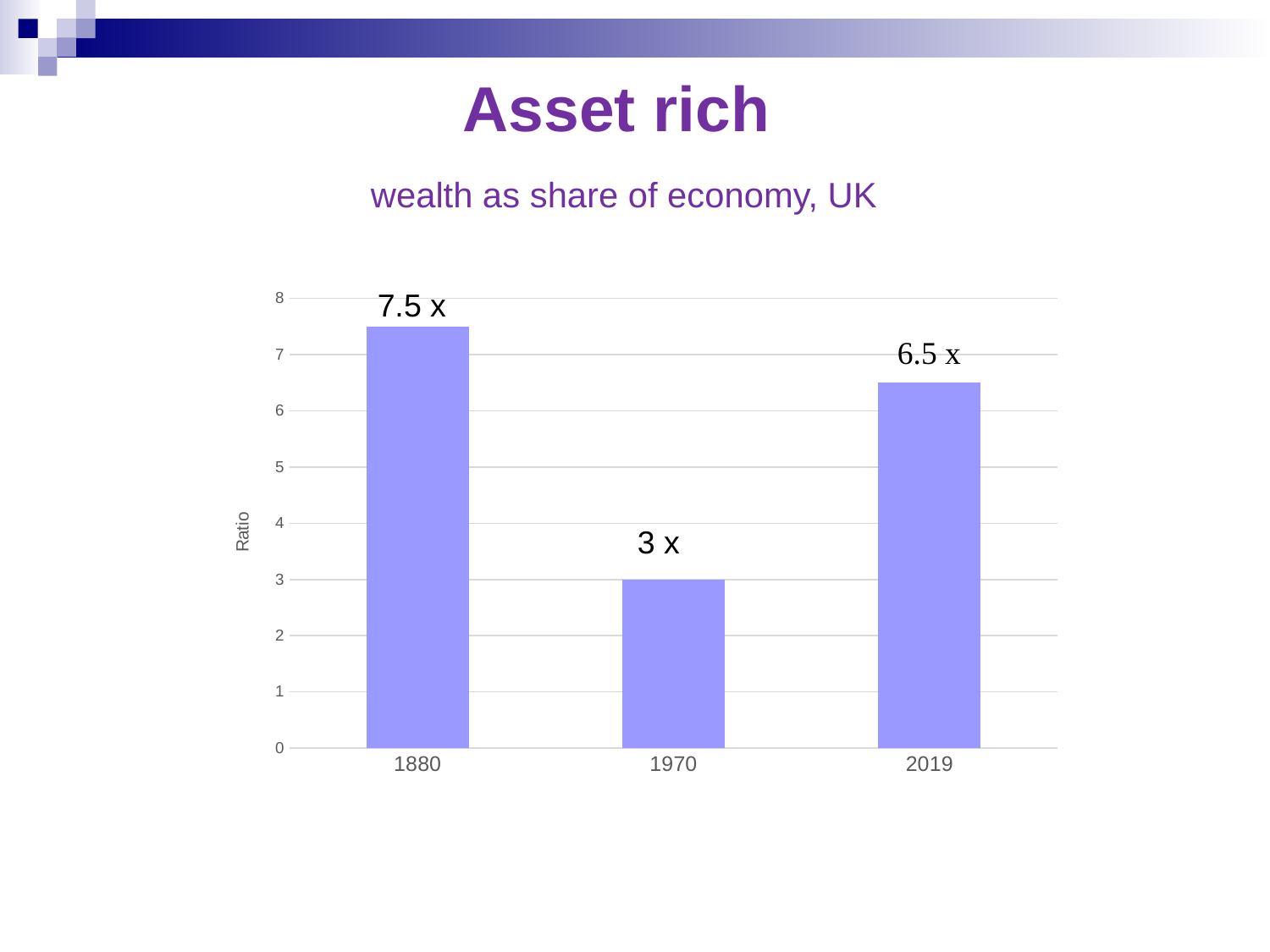
Is the value for 2019 greater or less than 6? greater What is the label on the vertical axis? Ratio What is the value for 2019? 6.5 x What is the difference between the values for 1880 and 2019? 1 x What is the value for 1970? 3 x Which is larger, the value for 1970 or the value for 2019? 2019 What is the value for 1880? 7.5 x What kind of chart is shown on the slide? bar chart What is the difference between the values for 2019 and 1970? 3.5 x Which year has the lowest value? 1970 Which year has the highest value? 1880 How many years are shown on the chart? 3